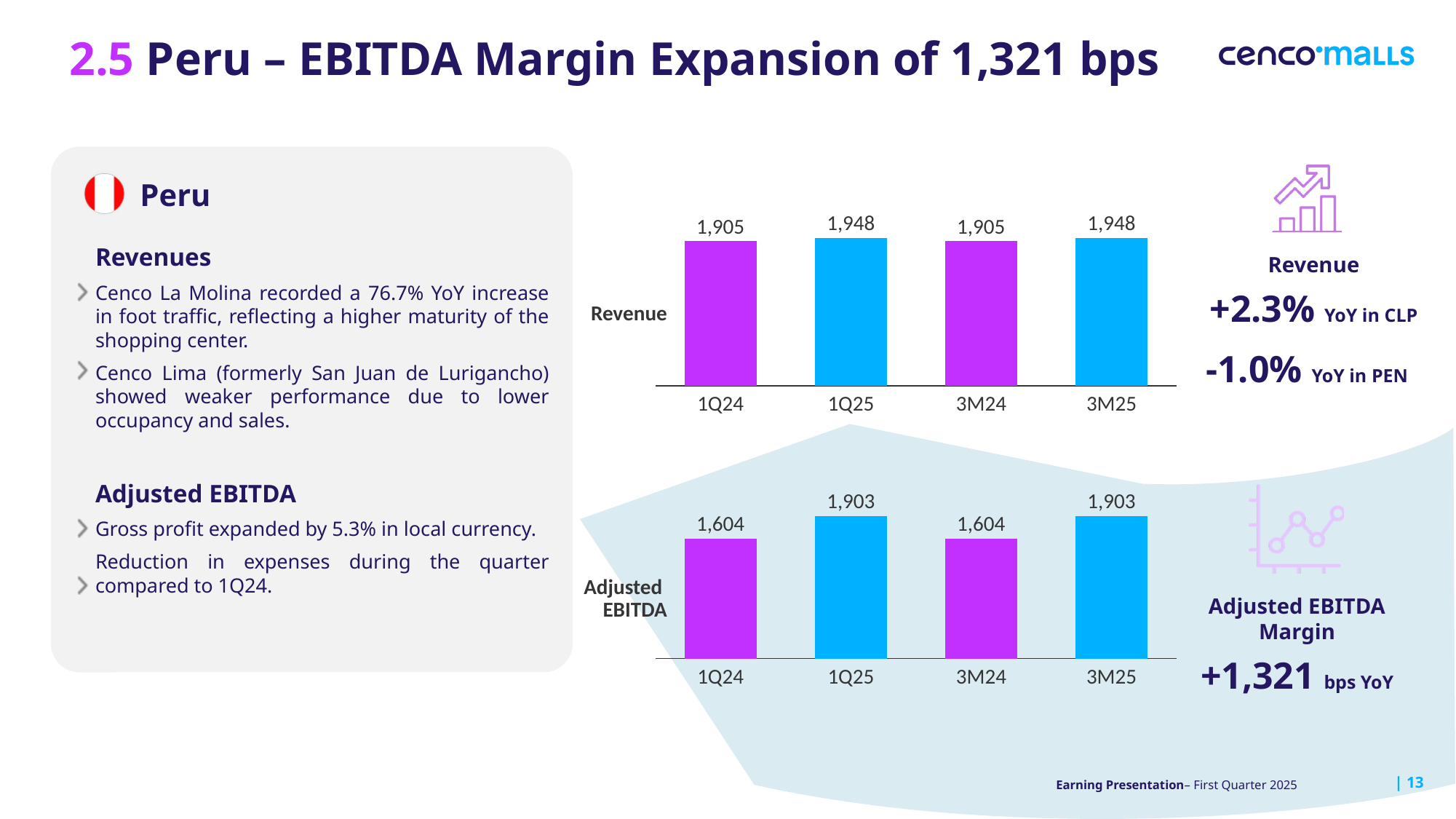
In the Revenue chart, what is the value for 1Q24? 1,905 How many bars are shown in the Revenue chart? 4 In the Adjusted EBITDA chart, which period has the lowest value? 1Q24 and 3M24 (both 1,604) In the Adjusted EBITDA chart, what is the difference between 1Q25 and 1Q24? 299 In the Revenue chart, what colour are the 1Q24 and 3M24 bars? Purple In the Adjusted EBITDA chart, what is the value for 3M25? 1,903 In the Revenue chart, what is the difference between 3M25 and 3M24? 43 In the Revenue chart, what is the value for 1Q25? 1,948 What type of chart is the Adjusted EBITDA chart? Bar chart In the Revenue chart, which is larger, 1Q24 or 1Q25? 1Q25 In the Adjusted EBITDA chart, what is the value for 1Q24? 1,604 In the Adjusted EBITDA chart, does the value rise or fall from 1Q24 to 1Q25? Rise